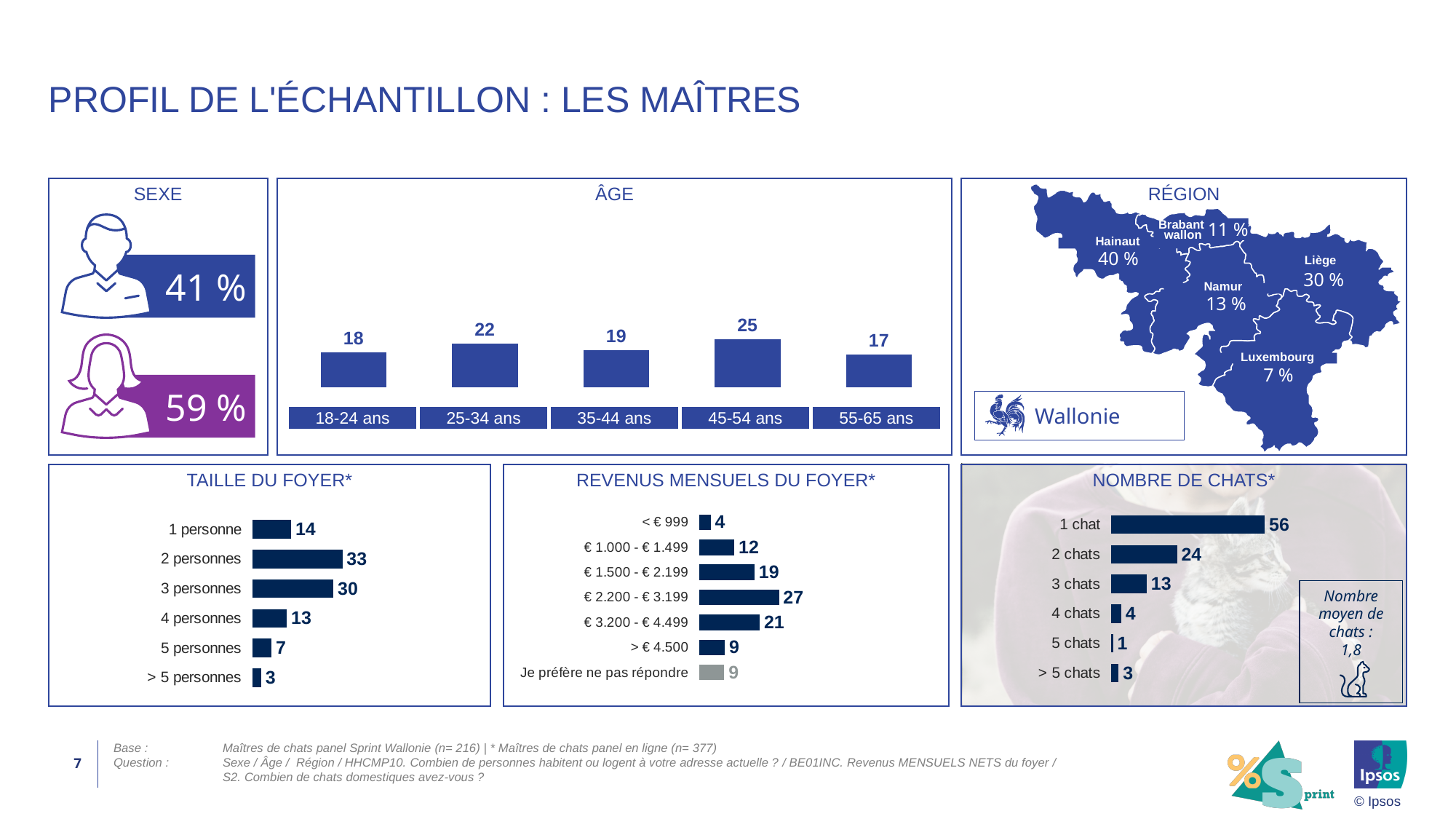
In the REVENUS MENSUELS DU FOYER chart, how many categories are shown? 7 In the ÂGE chart, which age group has the lowest value? 55-65 ans In the TAILLE DU FOYER chart, which category has the highest value? 2 personnes In the ÂGE chart, what is the difference between the values for 25-34 ans and 18-24 ans? 4 In the REVENUS MENSUELS DU FOYER chart, what is the value for € 2.200 - € 3.199? 27 In the NOMBRE DE CHATS chart, what is the value for 2 chats? 24 In the NOMBRE DE CHATS chart, what is the difference between the values for 1 chat and 3 chats? 43 In the TAILLE DU FOYER chart, what is the value for 3 personnes? 30 In the TAILLE DU FOYER chart, what kind of chart is used? bar chart In the REVENUS MENSUELS DU FOYER chart, which is larger: € 1.500 - € 2.199 or € 3.200 - € 4.499? € 3.200 - € 4.499 In the ÂGE chart, how many age groups are shown? 5 In the ÂGE chart, what is the value for 45-54 ans? 25